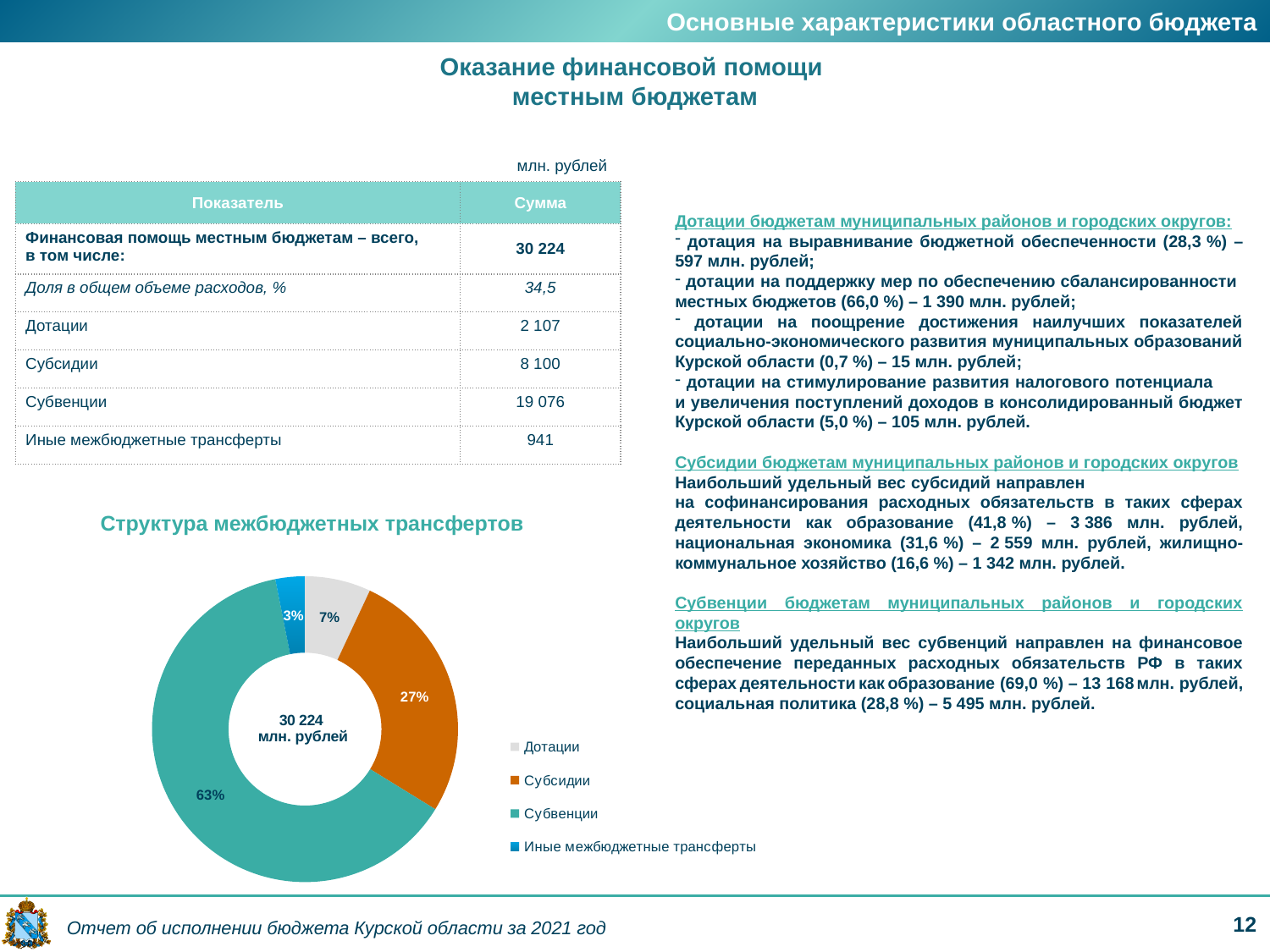
In the chart "Структура межбюджетных трансфертов", what share is shown for Дотации? 7% In the chart "Структура межбюджетных трансфертов", what share is shown for Иные межбюджетные трансферты? 3% In the chart "Структура межбюджетных трансфертов", which category has the smallest share? Иные межбюджетные трансферты How many categories does the legend of the chart "Структура межбюджетных трансфертов" list? 4 In the chart "Структура межбюджетных трансфертов", what share is shown for Субсидии? 27% In the chart "Структура межбюджетных трансфертов", which category has the largest share? Субвенции In the chart "Структура межбюджетных трансфертов", what is the difference in percentage points between the shares of Субвенции and Субсидии? 36 percentage points In the chart "Структура межбюджетных трансфертов", what share is shown for Субвенции? 63% What kind of chart is shown under the title "Структура межбюджетных трансфертов"? Doughnut (pie) chart In the chart "Структура межбюджетных трансфертов", what colour is the Субсидии slice? Orange In the chart "Структура межбюджетных трансфертов", which has a larger share: Дотации or Субсидии? Субсидии What total value is printed in the centre of the chart "Структура межбюджетных трансфертов"? 30 224 млн. рублей